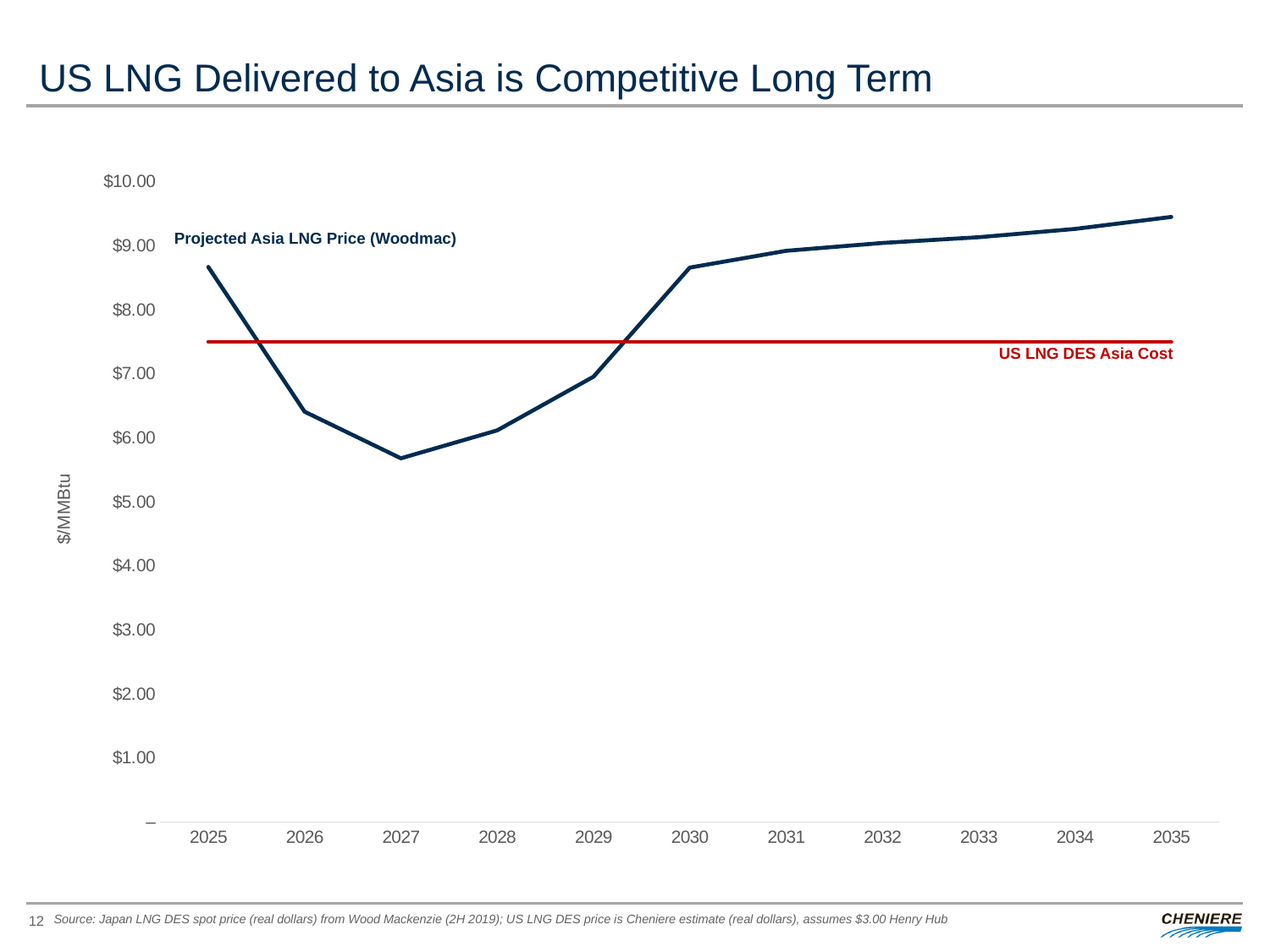
Is the US LNG DES Asia Cost greater or less than $7.00? greater In which year is the Projected Asia LNG Price (Woodmac) at its lowest? 2027 What kind of chart is shown on the slide? line chart Does the Projected Asia LNG Price (Woodmac) rise or fall from 2027 to 2035? rise In 2027, which is larger, the Projected Asia LNG Price (Woodmac) or the US LNG DES Asia Cost? US LNG DES Asia Cost How many years are shown on the x axis of the chart? 11 What unit is shown on the y axis of the chart? $/MMBtu Which is larger, the Projected Asia LNG Price (Woodmac) in 2025 or in 2027? 2025 In which year is the Projected Asia LNG Price (Woodmac) at its highest? 2035 Is the Projected Asia LNG Price (Woodmac) in 2035 greater or less than $9.00? greater Is the Projected Asia LNG Price (Woodmac) in 2027 greater or less than $6.00? less How many data series are plotted on the chart? 2